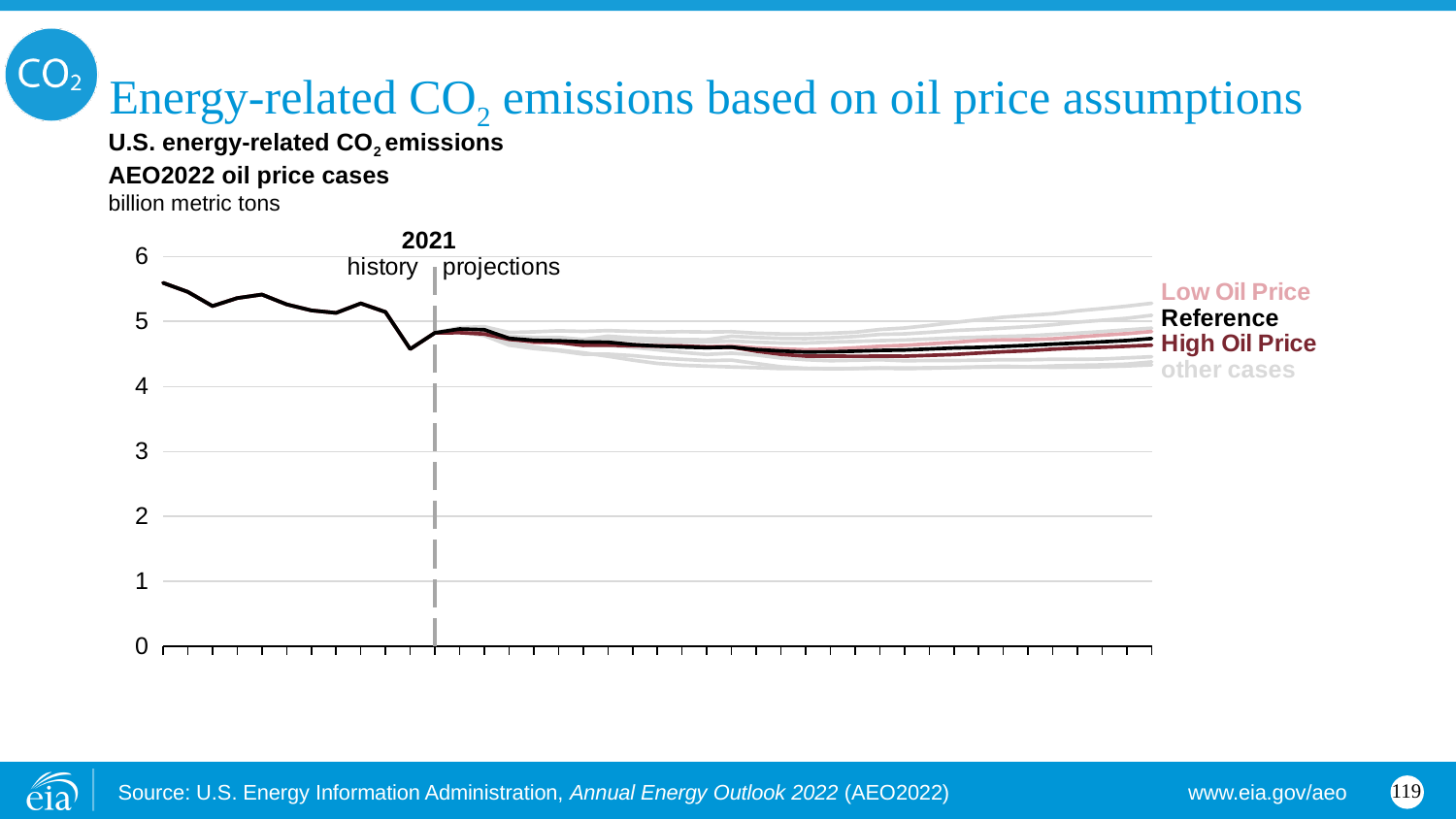
Is the value for the Reference case at the end of the projection period greater or less than 4? greater Is the value at the start of the history period greater or less than 5? greater How many series labels are shown to the right of the chart? 4 Is the value for the High Oil Price case at the end of the projection period greater or less than 5? less What unit is used for the y axis of the chart? billion metric tons Which series is labelled in dark red on the chart? High Oil Price Which year separates history from projections on the chart? 2021 At the end of the projection period, which is higher: the Low Oil Price case or the High Oil Price case? Low Oil Price What is the highest value shown on the y axis of the chart? 6 What kind of chart is shown on the slide? line chart Do emissions generally rise or fall over the history period shown on the chart? fall